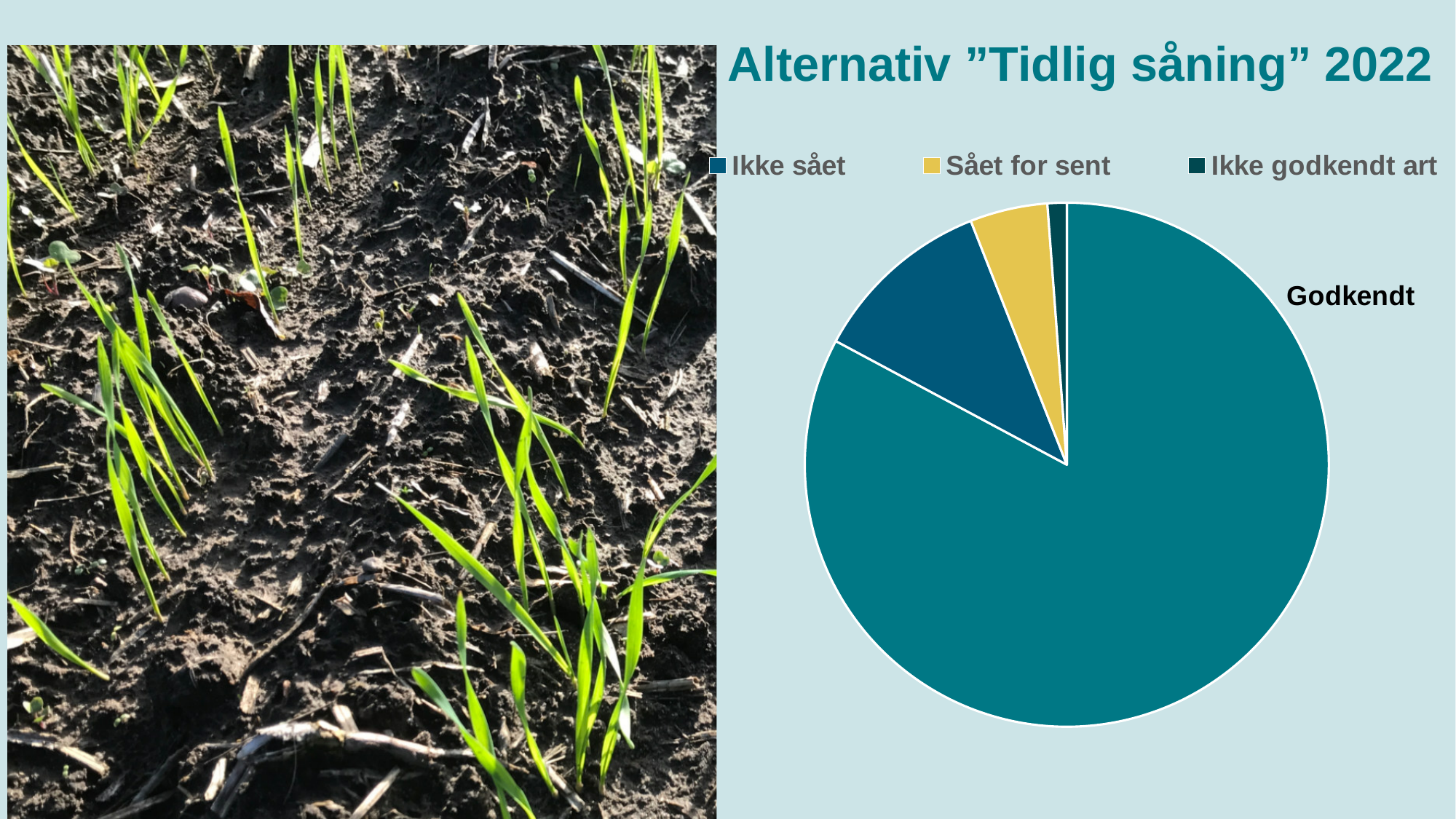
How many slices does the pie chart have? 4 Which slice is larger, Ikke sået or Sået for sent? Ikke sået What is the title of the chart? Alternativ "Tidlig såning" 2022 Which slice is larger, Sået for sent or Ikke godkendt art? Sået for sent How many entries does the legend list? 3 What kind of chart is shown on the slide? Pie chart Which category is shown in yellow in the pie chart? Sået for sent Which slice is larger, Godkendt or Ikke sået? Godkendt Which category has the largest slice of the pie? Godkendt Which category has the smallest slice of the pie? Ikke godkendt art